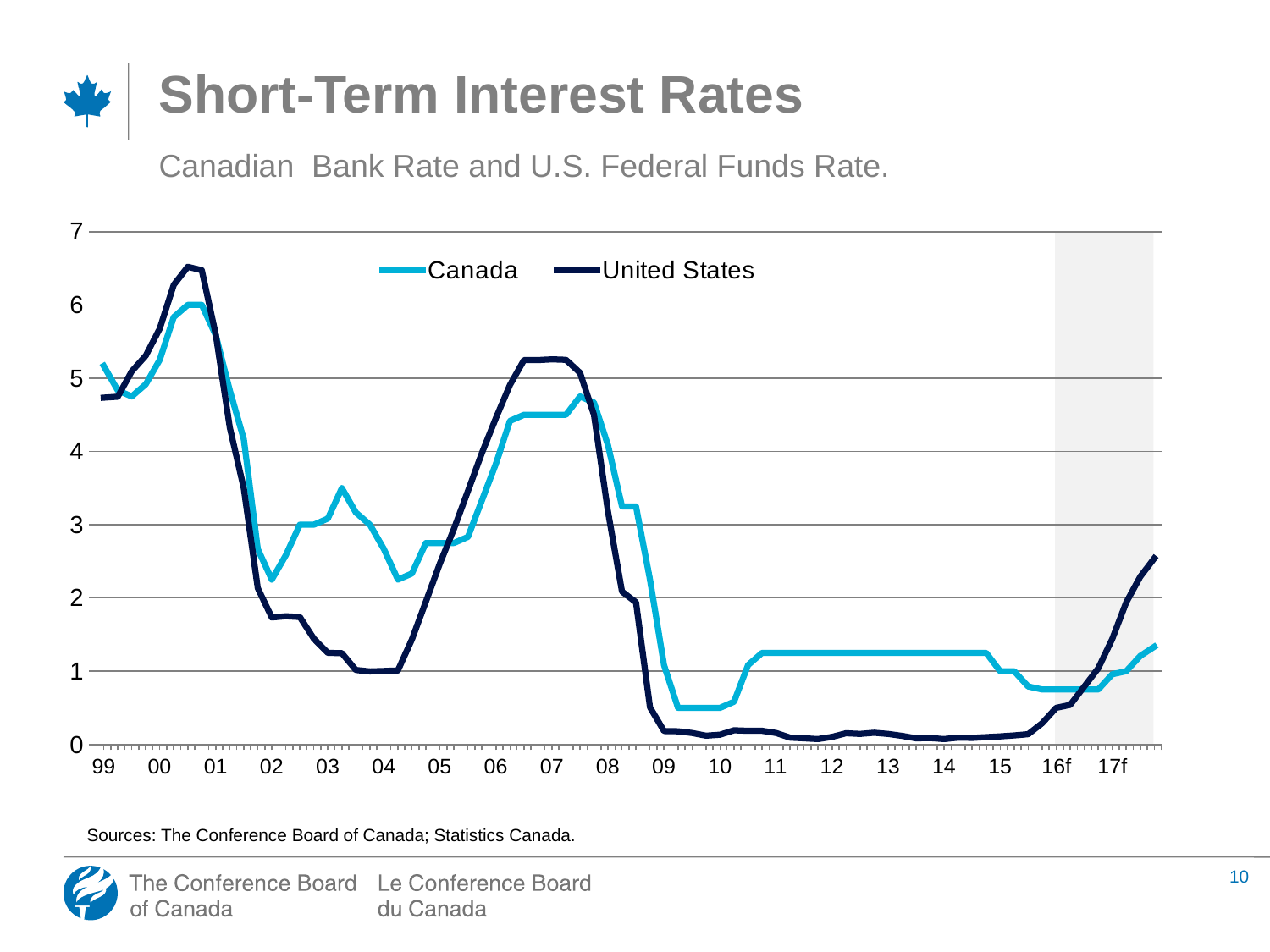
What are the two series named in the legend? Canada and United States Is the value for the United States around 2000 greater or less than 6? greater In 2013, which series has the higher value, Canada or United States? Canada Is the value for the United States at the end of 17f greater or less than 2? greater Does the United States series rise or fall from 2015 to 17f? rise Is the value for the United States in 2013 greater or less than 1? less How many series does the legend list? 2 What kind of chart is shown on the slide? line chart In 2007, which series has the higher value, Canada or United States? United States What is the title of the chart on the slide? Short-Term Interest Rates